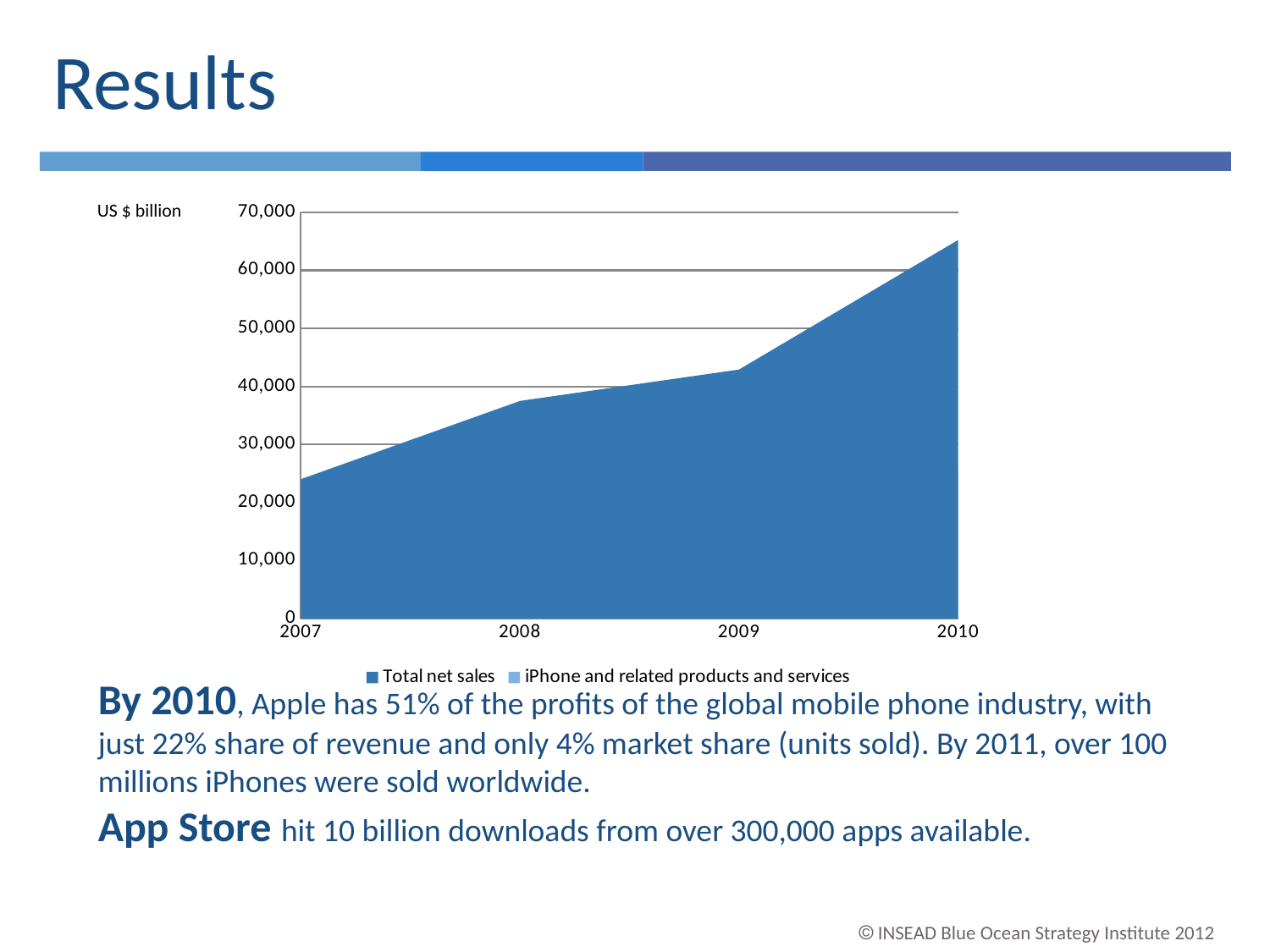
Is the value for Total net sales in 2010 greater or less than 60,000? greater Which year has the highest Total net sales? 2010 Does Total net sales rise or fall from 2007 to 2010? Rise What kind of chart is shown on the slide? Area chart How many years are shown on the x axis of the chart? 4 Is the value for Total net sales in 2007 greater or less than 30,000? less Is the value for Total net sales in 2008 greater or less than 40,000? less How many series does the chart legend list? 2 Which is larger, Total net sales in 2009 or in 2010? 2010 What unit label is shown at the top left of the chart? US $ billion Which year has the lowest Total net sales? 2007